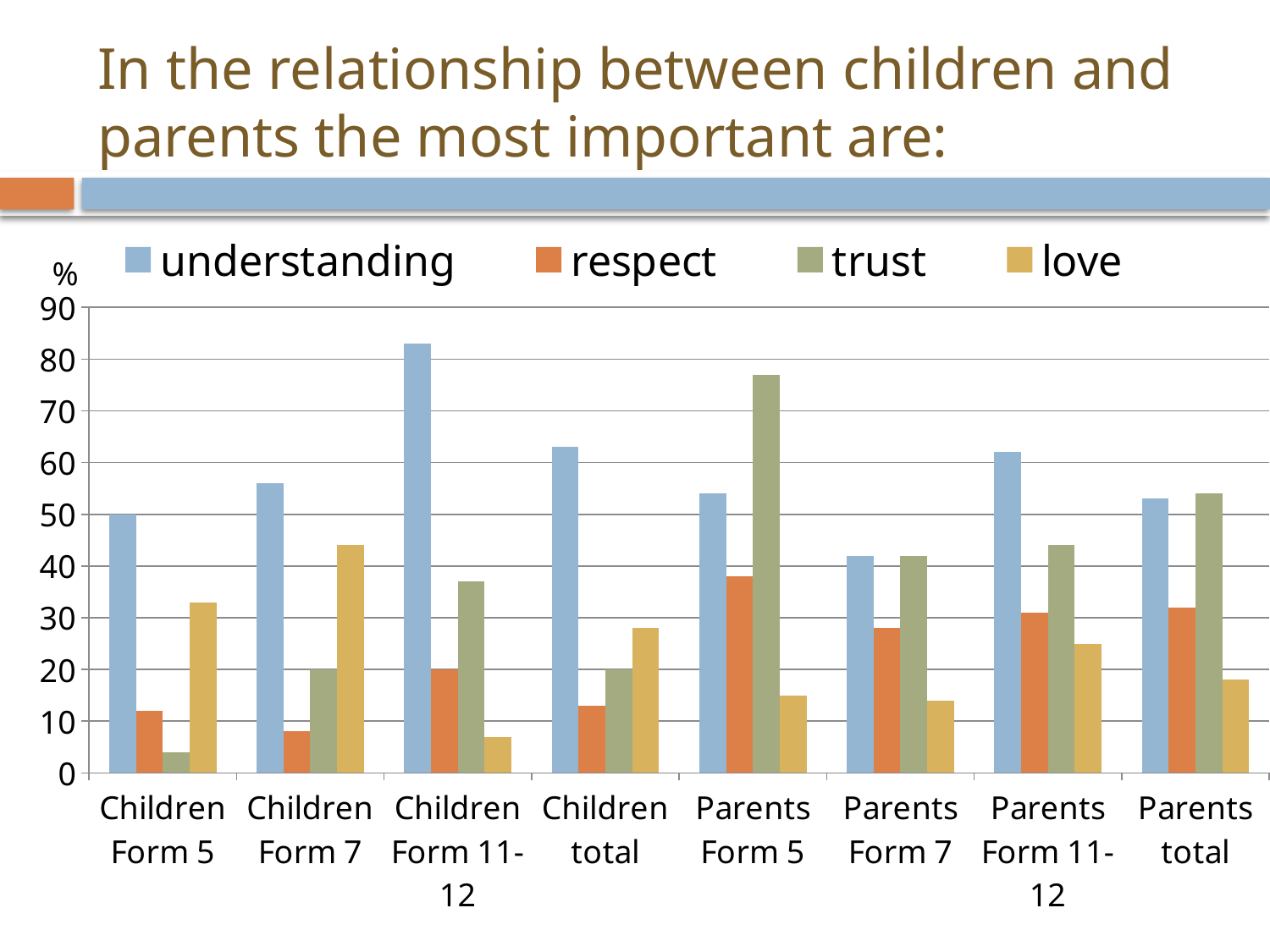
Which category has the highest bar for understanding? Children Form 11-12 Is the value for love in Children Form 11-12 greater or less than 10? less What colour represents respect in the legend? orange How many series does the legend list? 4 In Children Form 7, which is larger: love or trust? love What unit is shown on the y axis? % In Parents Form 5, which is larger: trust or understanding? trust How many categories are shown along the x axis? 8 Which category has the lowest bar for trust? Children Form 5 What kind of chart is shown on the slide? bar chart Is the value for understanding in Children Form 11-12 greater or less than 80? greater Is the value for trust in Parents Form 5 greater or less than 70? greater